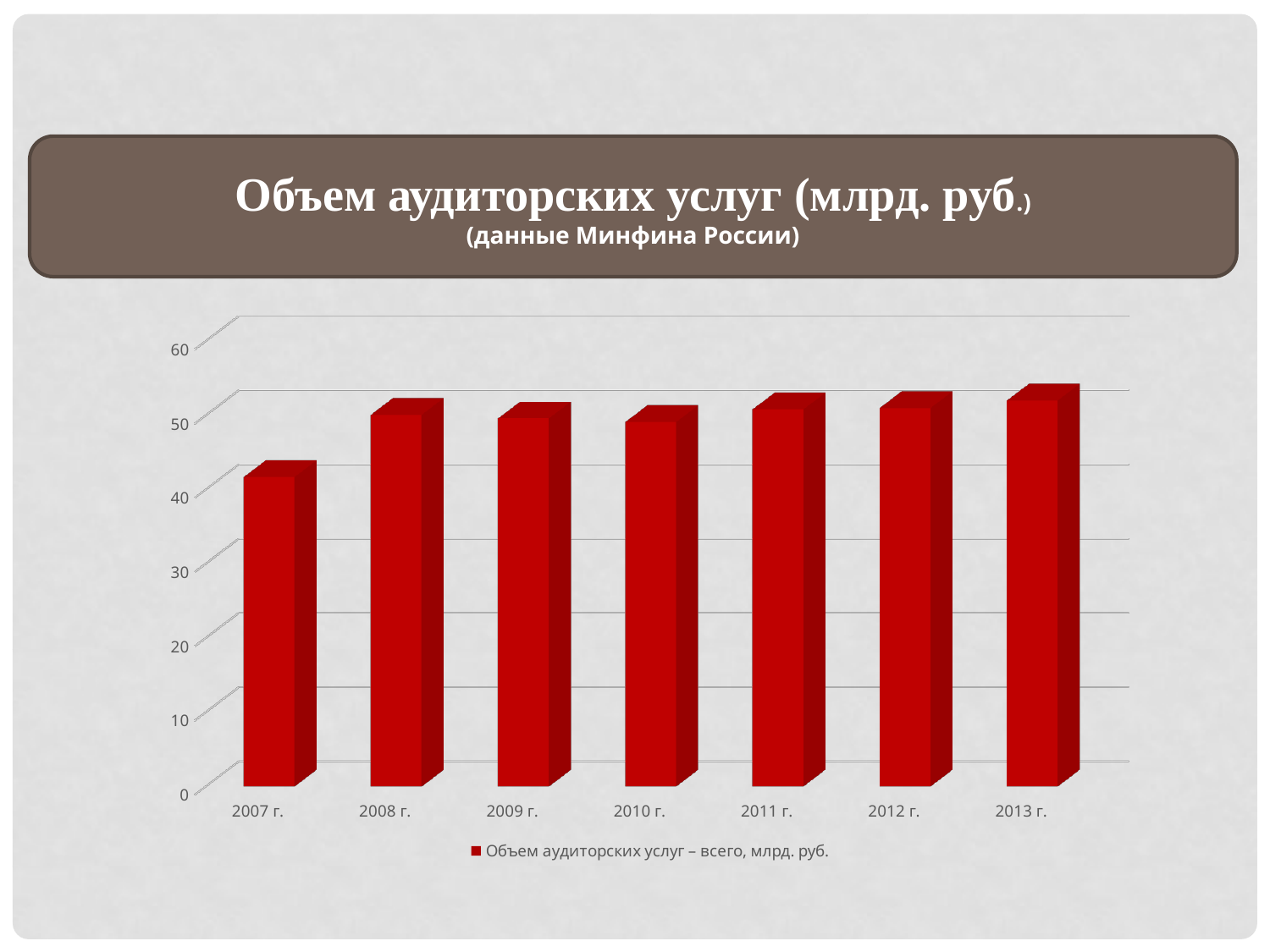
How many years are shown on the x axis of the chart? 7 How many series does the chart legend list? 1 Is the value for 2007 г. greater or less than 50? less What kind of chart is shown on the slide? bar chart Does the value rise or fall from 2007 г. to 2008 г.? rise Which is larger, the value for 2007 г. or the value for 2008 г.? 2008 г. Is the value for 2013 г. greater or less than 60? less Which is larger, the value for 2010 г. or the value for 2013 г.? 2013 г. What is the legend entry for the series in the chart? Объем аудиторских услуг – всего, млрд. руб. Which year has the lowest value in the chart? 2007 г.